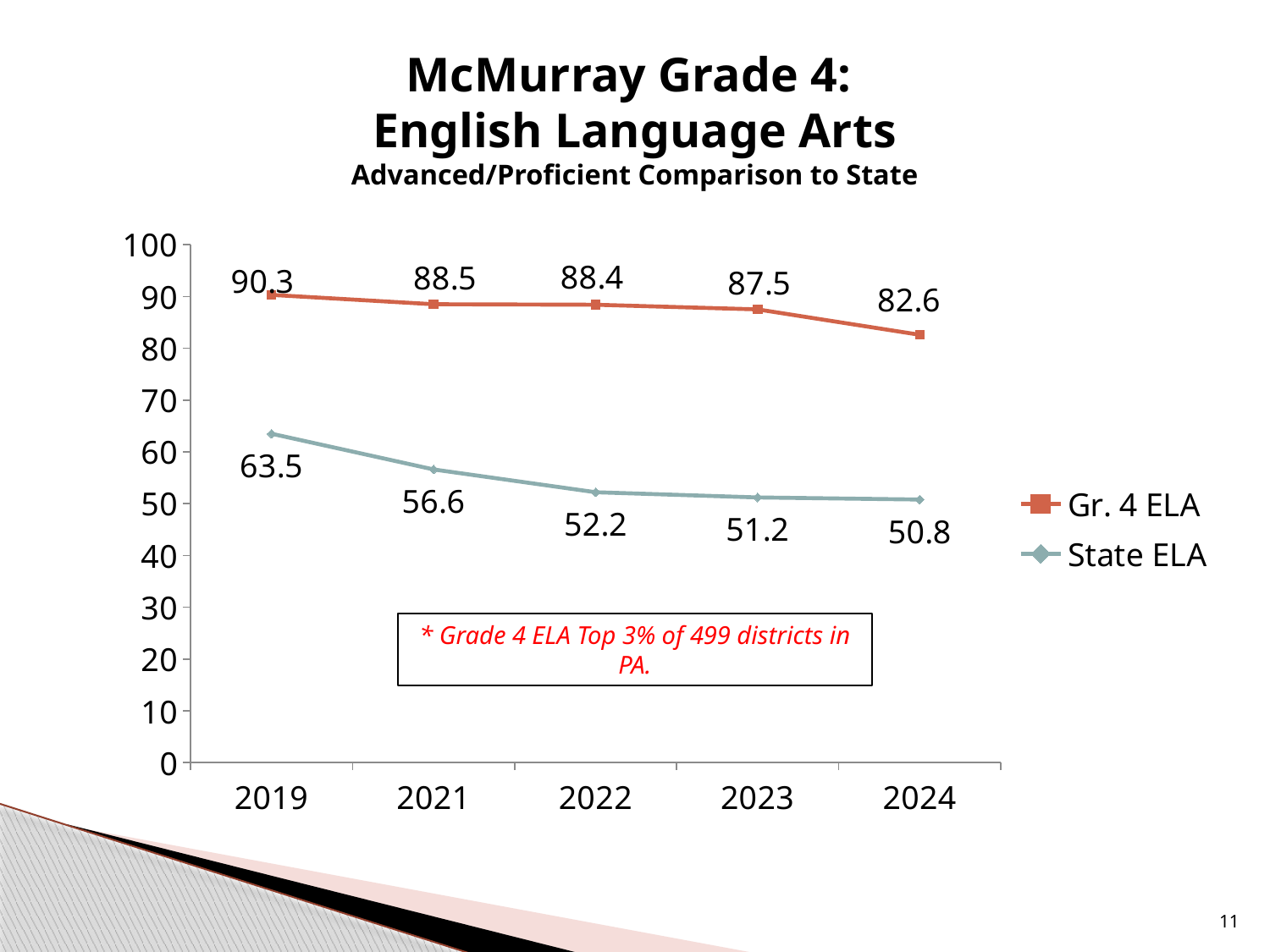
What is the difference between the Gr. 4 ELA and State ELA values in 2022? 36.2 What is the Gr. 4 ELA value for 2019? 90.3 What is the Gr. 4 ELA value for 2023? 87.5 Is the State ELA value for 2019 greater or less than 60? greater Which is larger in 2021, the Gr. 4 ELA value or the State ELA value? Gr. 4 ELA How many years are shown on the x axis? 5 What kind of chart is shown on the slide? line chart In which year is the Gr. 4 ELA value highest? 2019 What is the State ELA value for 2024? 50.8 Does the Gr. 4 ELA series rise or fall from 2019 to 2024? fall How many series does the legend list? 2 In which year is the State ELA value lowest? 2024